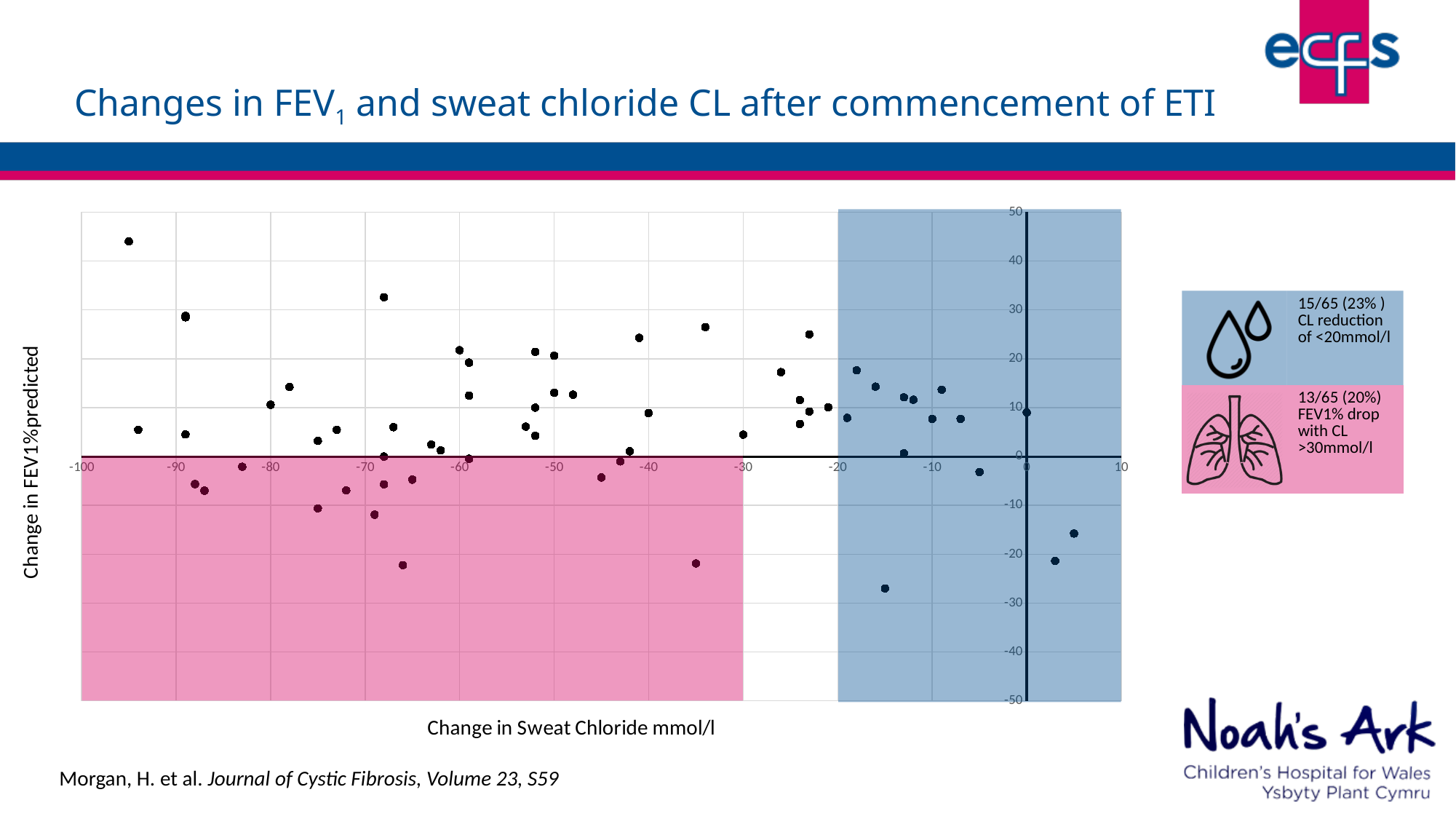
What is the title of the y axis of the chart? Change in FEV1%predicted Is the change in sweat chloride for the highest point on the chart greater or less than -90? less Is the change in FEV1%predicted for the highest point on the chart greater or less than 40? greater How many patients in total are represented in the chart, according to the annotations? 65 According to the annotation next to the chart, how many patients had an FEV1% drop with CL >30mmol/l? 13/65 (20%) What is the highest value shown on the y axis of the chart? 50 Is the change in FEV1%predicted for the lowest point on the chart greater or less than -20? less What is the title of the x axis of the chart? Change in Sweat Chloride mmol/l What kind of chart is shown on the slide? scatter plot What is the lowest value shown on the x axis of the chart? -100 According to the annotation next to the chart, how many patients had a CL reduction of <20mmol/l? 15/65 (23%) What is the highest value shown on the x axis of the chart? 10